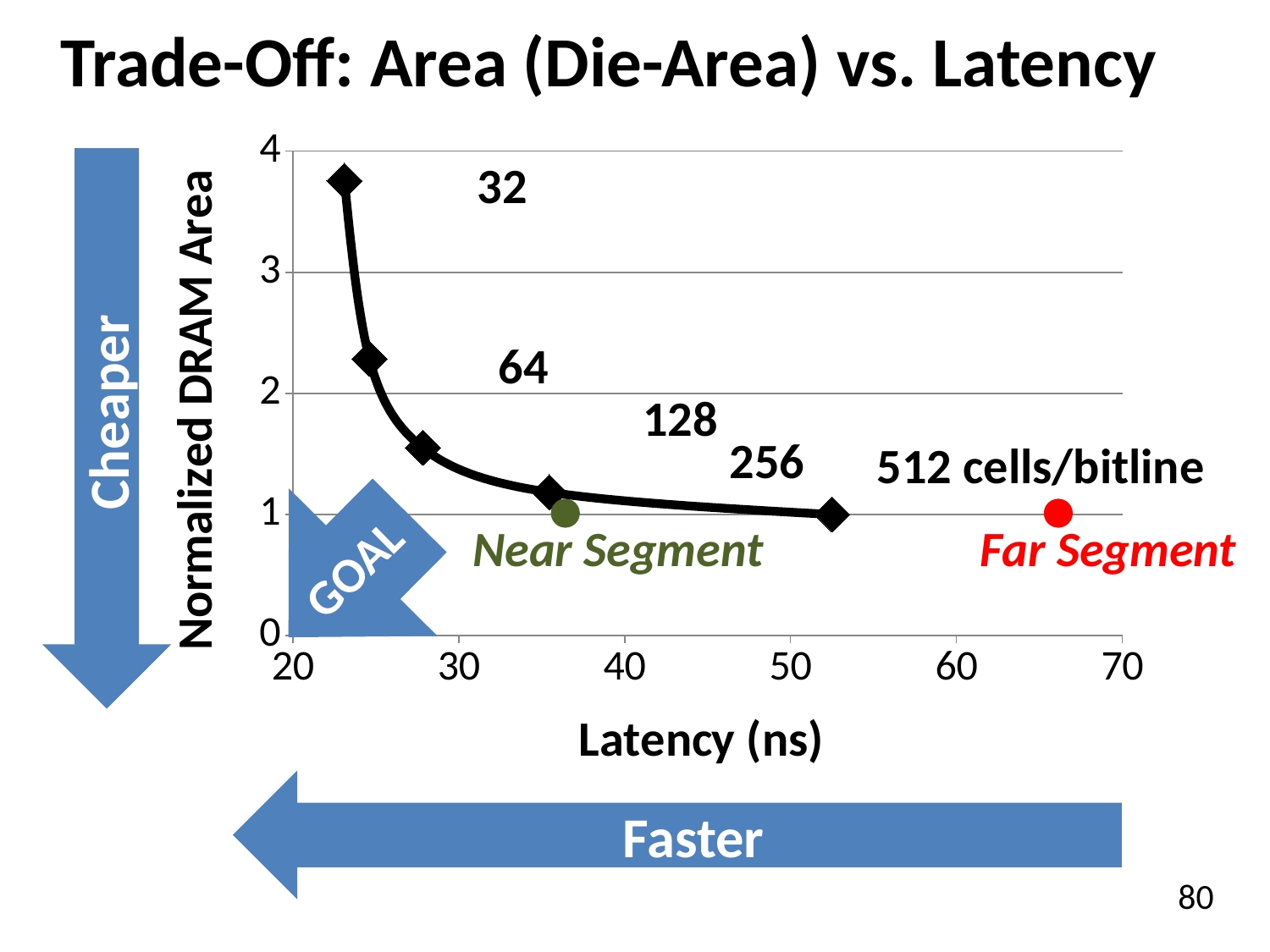
Which has the higher latency, the Near Segment or the Far Segment? Far Segment As latency increases along the x axis, does the normalized DRAM area rise or fall? fall What is the title of the chart on this slide? Trade-Off: Area (Die-Area) vs. Latency Which cells/bitline configuration has the lowest normalized DRAM area? 512 Which cells/bitline configuration has the highest normalized DRAM area? 32 Is the latency for 512 cells/bitline greater or less than 50 ns? greater What is the label of the x axis of the chart? Latency (ns) Is the latency of the Far Segment point greater or less than 60 ns? greater Which has the larger normalized DRAM area, 64 cells/bitline or 256 cells/bitline? 64 cells/bitline Is the normalized DRAM area for 32 cells/bitline greater or less than 3? greater How many cells/bitline data points (diamond markers) are plotted on the black curve? 5